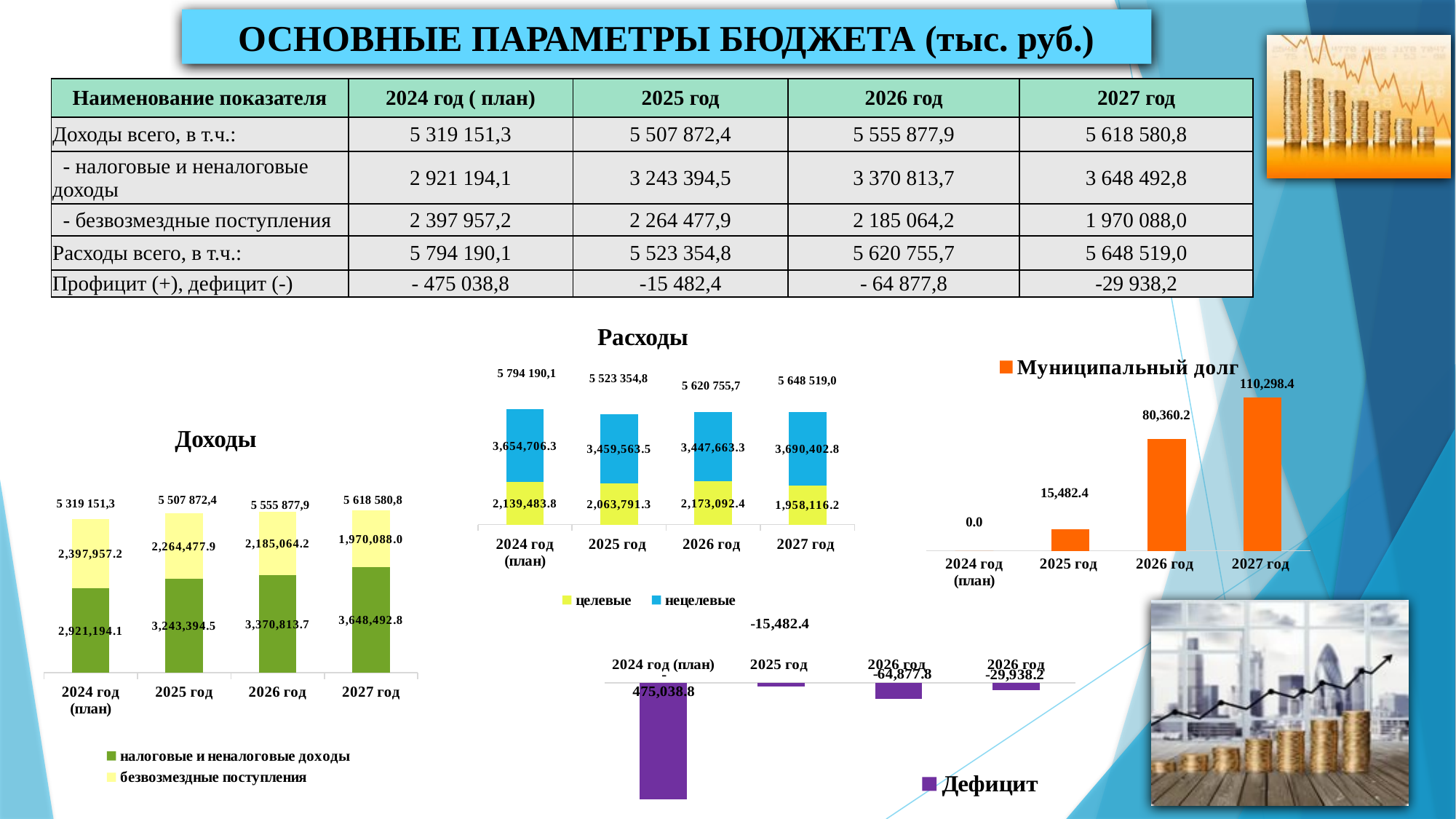
In the "Расходы" chart, which year has the lowest value for целевые? 2027 год In the "Расходы" chart, what is the value of нецелевые for 2026 год? 3,447,663.3 In the "Муниципальный долг" chart, how many categories are shown on the x axis? 4 In the "Муниципальный долг" chart, what is the value for 2026 год? 80,360.2 In the "Муниципальный долг" chart, which year has the highest value? 2027 год In the "Доходы" chart, what is the value of налоговые и неналоговые доходы for 2027 год? 3,648,492.8 In the "Доходы" chart, do the values for безвозмездные поступления rise or fall from 2024 год (план) to 2027 год? fall In the "Расходы" chart, what is the difference between нецелевые and целевые for 2024 год (план)? 1,515,222.5 In the "Доходы" chart, what is the value of безвозмездные поступления for 2024 год (план)? 2,397,957.2 In the "Доходы" chart, what is the total of the stacked bar for 2025 год? 5 507 872,4 In the "Доходы" chart, how many series does the legend list? 2 In the "Дефицит" chart, what is the value for 2025 год? -15,482.4